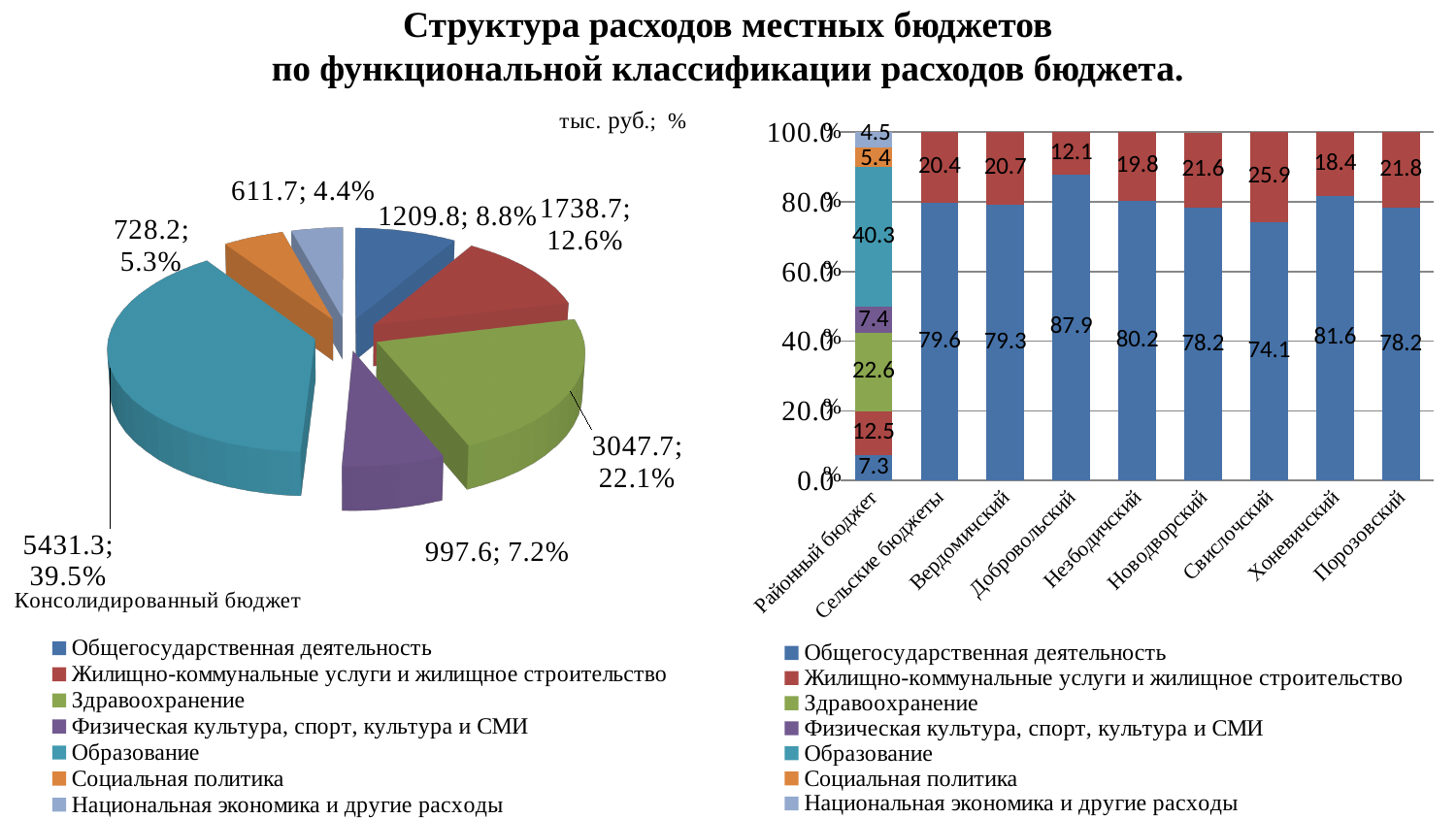
In the pie chart on the left, what is the value shown for Образование? 5431.3; 39.5% In the pie chart on the left, what is the difference in thousand rubles between Жилищно-коммунальные услуги и жилищное строительство and Общегосударственная деятельность? 528.9 In the bar chart on the right, which is larger: Общегосударственная деятельность for Хоневичский or for Незбодичский? Хоневичский What type of chart is on the right side of the slide? Stacked bar chart In the bar chart on the right, what is the value of Образование for Районный бюджет? 40.3 In the bar chart on the right, which budget has the highest value for Жилищно-коммунальные услуги и жилищное строительство? Свислочский In the bar chart on the right, what is the value of Общегосударственная деятельность for Добровольский? 87.9 In the bar chart on the right, how many budget categories are shown on the x axis? 9 In the pie chart on the left, which category has the smallest slice? Национальная экономика и другие расходы In the pie chart on the left, how many slices are there? 7 In the pie chart on the left, what share does Здравоохранение have? 22.1% In the pie chart on the left, which category has the largest slice? Образование